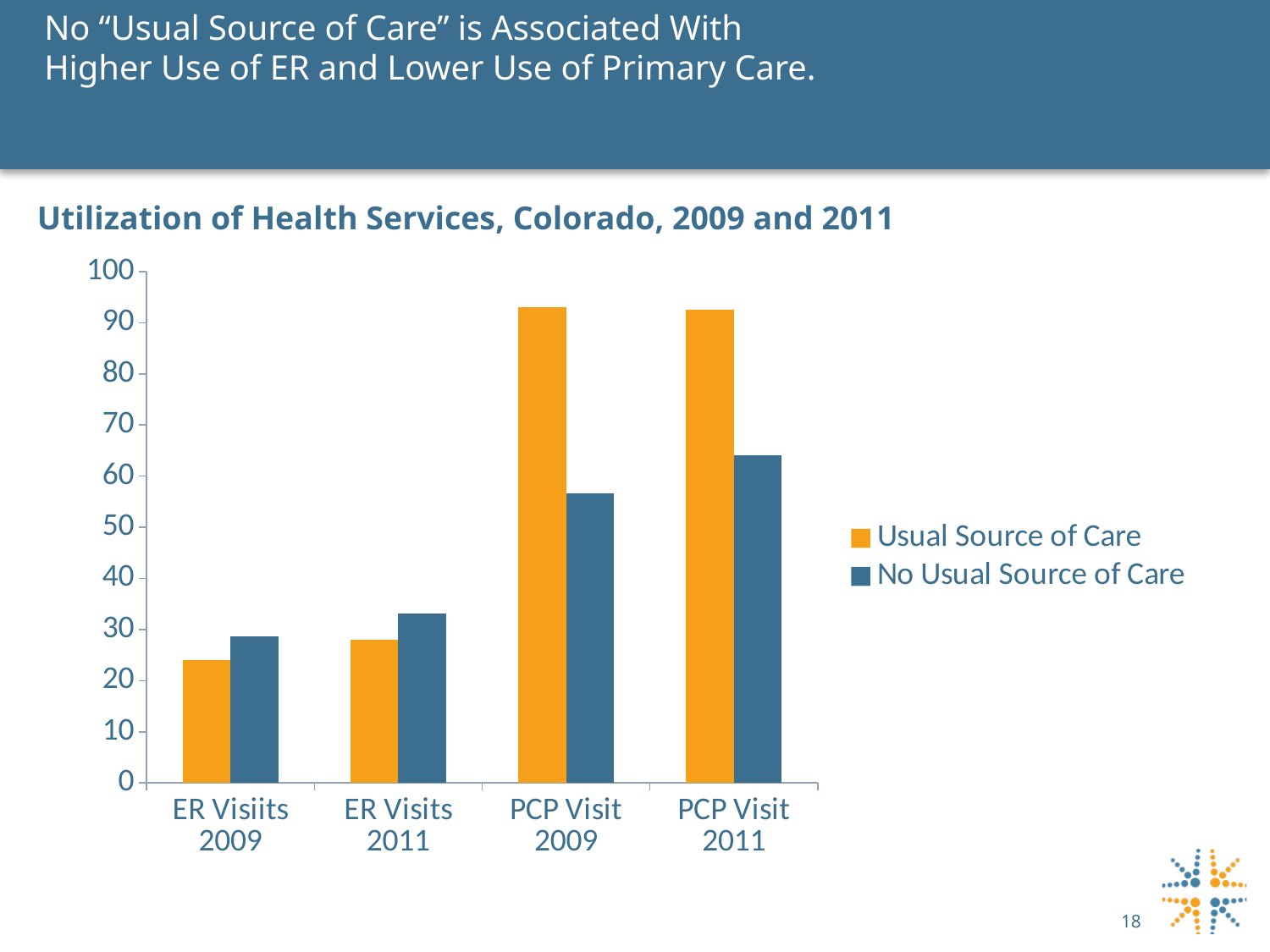
Which series is shown in orange? Usual Source of Care Is the value for No Usual Source of Care at PCP Visit 2009 greater or less than 60? less What is the title of the chart? Utilization of Health Services, Colorado, 2009 and 2011 Is the value for Usual Source of Care at ER Visiits 2009 greater or less than 30? less For which category is the No Usual Source of Care value highest? PCP Visit 2011 Is the value for No Usual Source of Care at ER Visits 2011 greater or less than 30? greater What kind of chart is shown on the slide? bar chart At PCP Visit 2009, which series has the larger value, Usual Source of Care or No Usual Source of Care? Usual Source of Care How many categories are shown on the x axis? 4 How many series does the legend list? 2